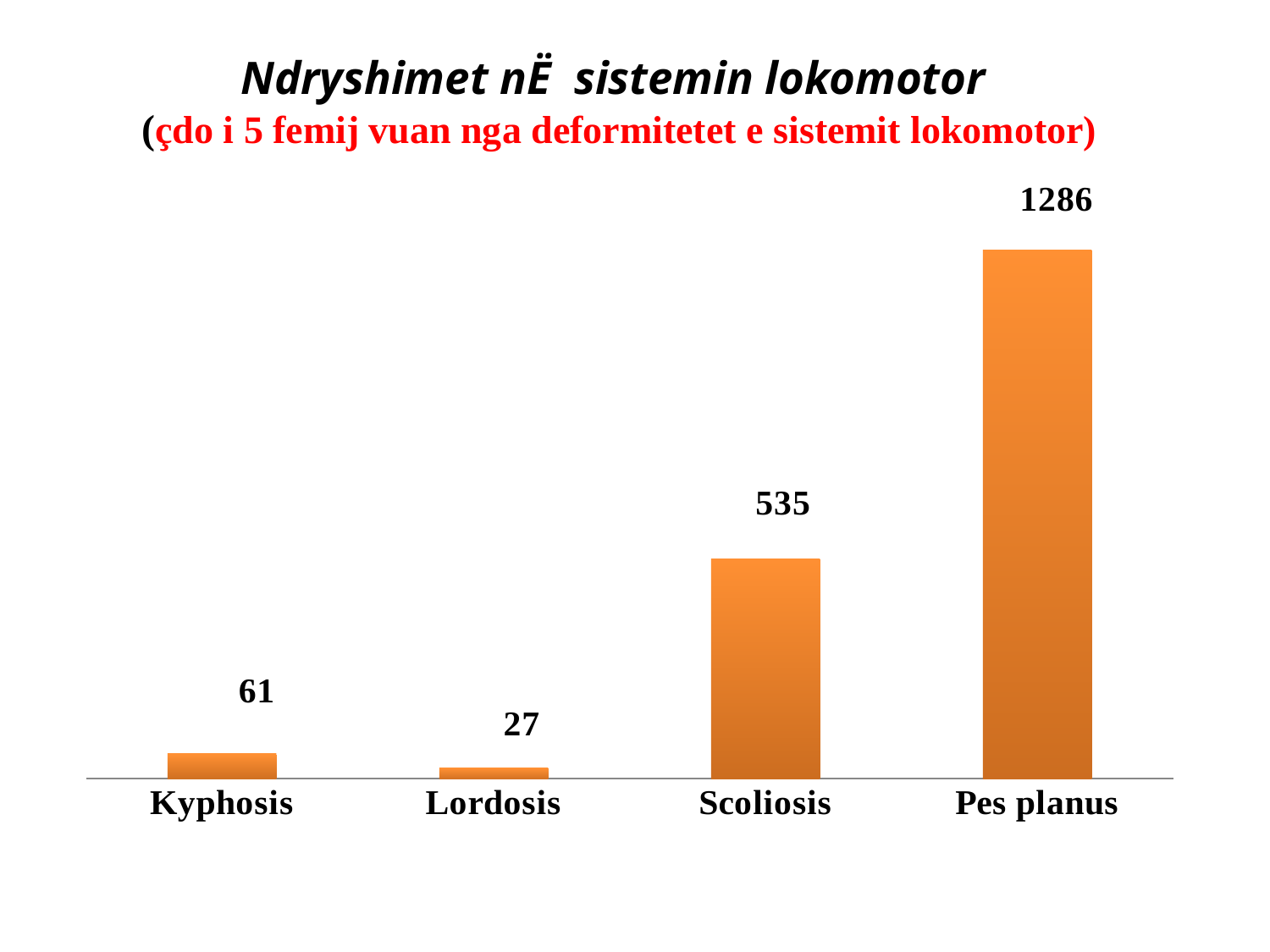
What kind of chart is shown on the slide? Bar chart What is the difference between the values for Pes planus and Scoliosis? 751 What is the value for Pes planus? 1286 What is the value for Kyphosis? 61 Which category has the highest value? Pes planus What is the value for Scoliosis? 535 What is the difference between the values for Kyphosis and Lordosis? 34 Which is larger, the value for Scoliosis or the value for Kyphosis? Scoliosis How many categories are shown on the x axis? 4 Which category has the lowest value? Lordosis What colour are the bars in the chart? Orange What is the value for Lordosis? 27